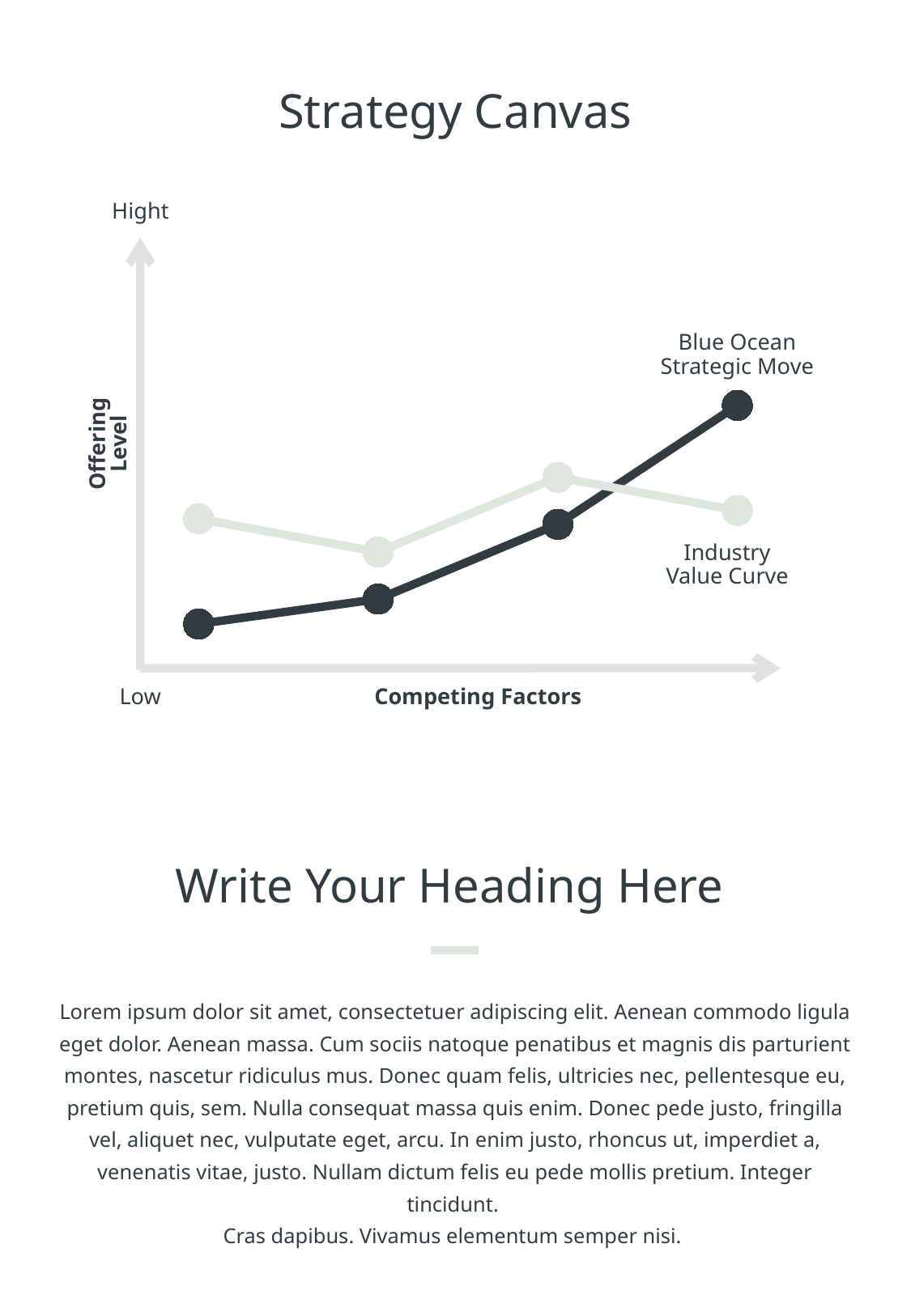
At the leftmost point, which series has the higher offering level, Blue Ocean Strategic Move or Industry Value Curve? Industry Value Curve How many series are plotted on the chart? 2 Which series has the lowest point on the chart? Blue Ocean Strategic Move How many data points does the Blue Ocean Strategic Move line have? 4 Which series reaches the highest point on the chart? Blue Ocean Strategic Move How many data points does the Industry Value Curve line have? 4 Does the Blue Ocean Strategic Move line rise or fall from left to right? rise What is the label of the horizontal axis? Competing Factors What kind of chart is shown on the slide? line chart What is the title of the chart? Strategy Canvas At the rightmost point, which series has the higher offering level, Blue Ocean Strategic Move or Industry Value Curve? Blue Ocean Strategic Move